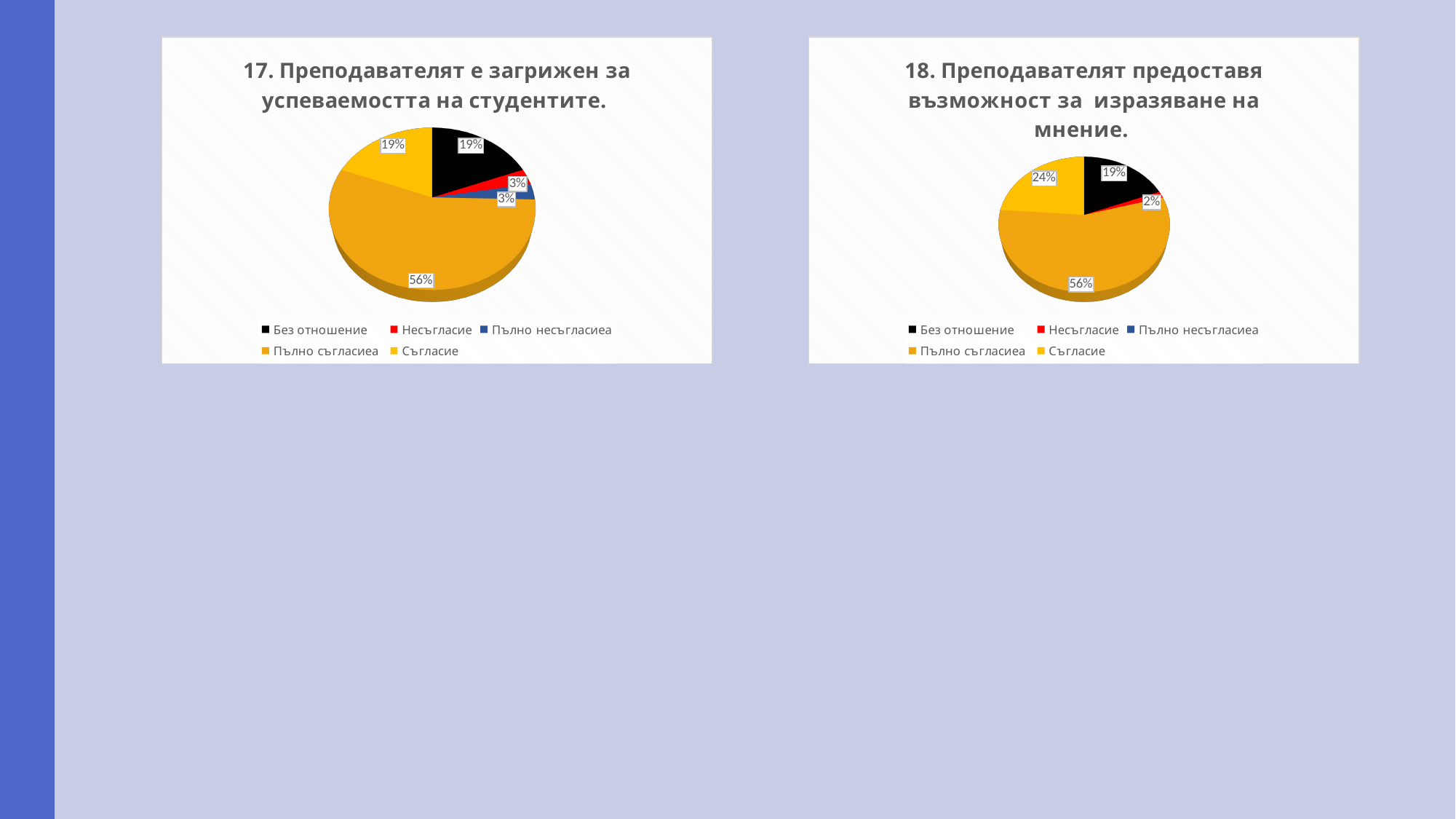
In the left chart (17), what share of the pie is Пълно съгласиеа? 56% In the right chart (18), what percentage is shown for Несъгласие? 2% In the left chart (17), what percentage is shown for Без отношение? 19% How many entries does the legend of the left chart (17) list? 5 In the right chart (18), which is larger: Съгласие or Без отношение? Съгласие In the left chart (17), which category has the largest slice? Пълно съгласиеа In the left chart (17), what percentage is shown for Несъгласие? 3% In the right chart (18), what share of the pie is Съгласие? 24% In the right chart (18), which category has the largest slice? Пълно съгласиеа What type of chart is the right chart (18)? Pie chart In the right chart (18), what is the difference in percentage points between Пълно съгласиеа and Съгласие? 32 In the left chart (17), what is the difference in percentage points between Пълно съгласиеа and Без отношение? 37